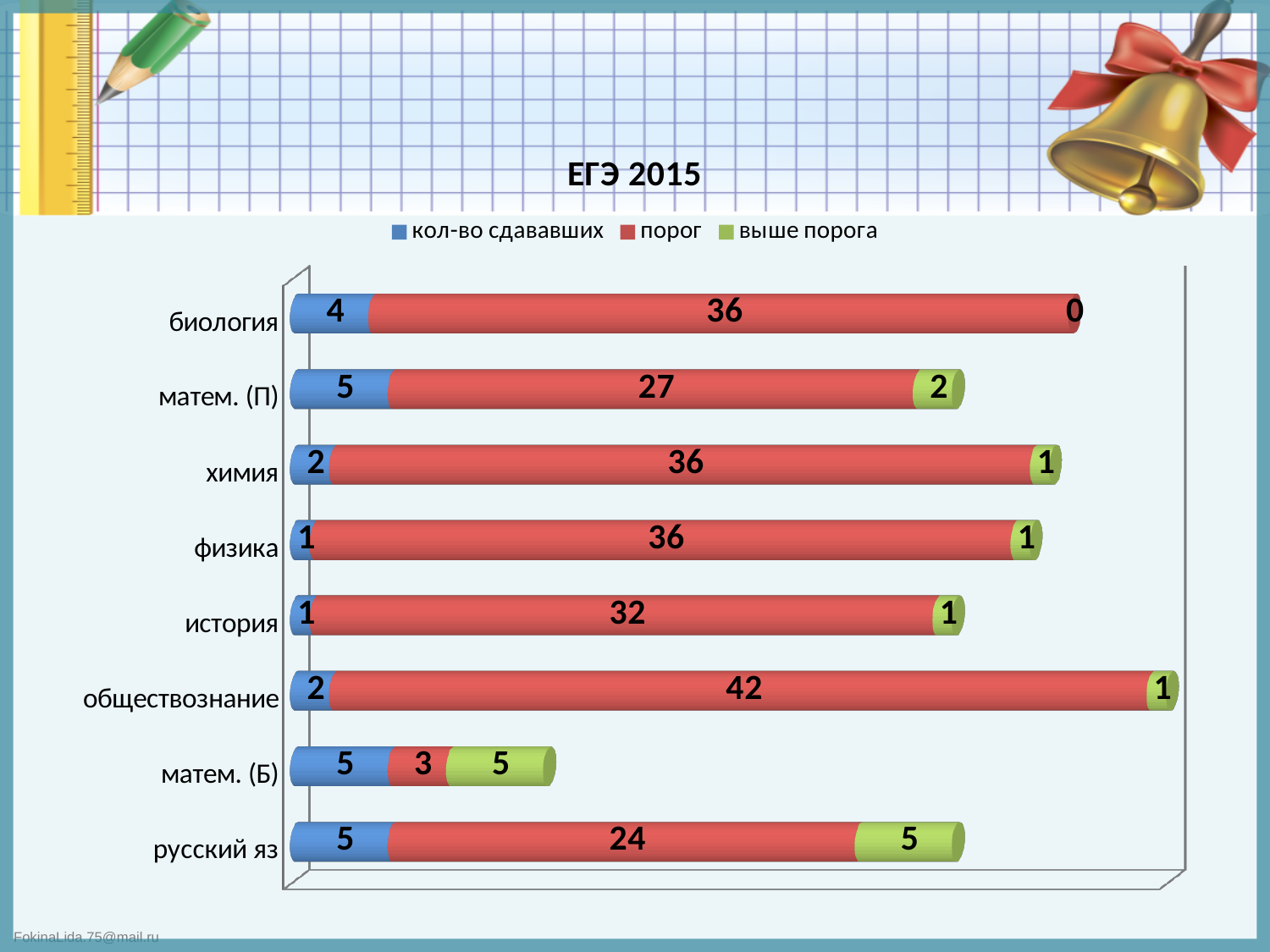
What kind of chart is shown on the slide? stacked bar chart How many categories are shown on the chart? 8 Which category has the lowest value of порог? матем. (Б) What is the total of the stacked bar for матем. (Б)? 13 What is the value of выше порога for русский яз? 5 What is the difference between the порог values for обществознание and русский яз? 18 How many series does the legend list? 3 What is the value of кол-во сдававших for биология? 4 What is the title of the chart? ЕГЭ 2015 Which is larger: the порог value for история or for матем. (П)? история Which category has the highest value of порог? обществознание What is the value of порог for обществознание? 42